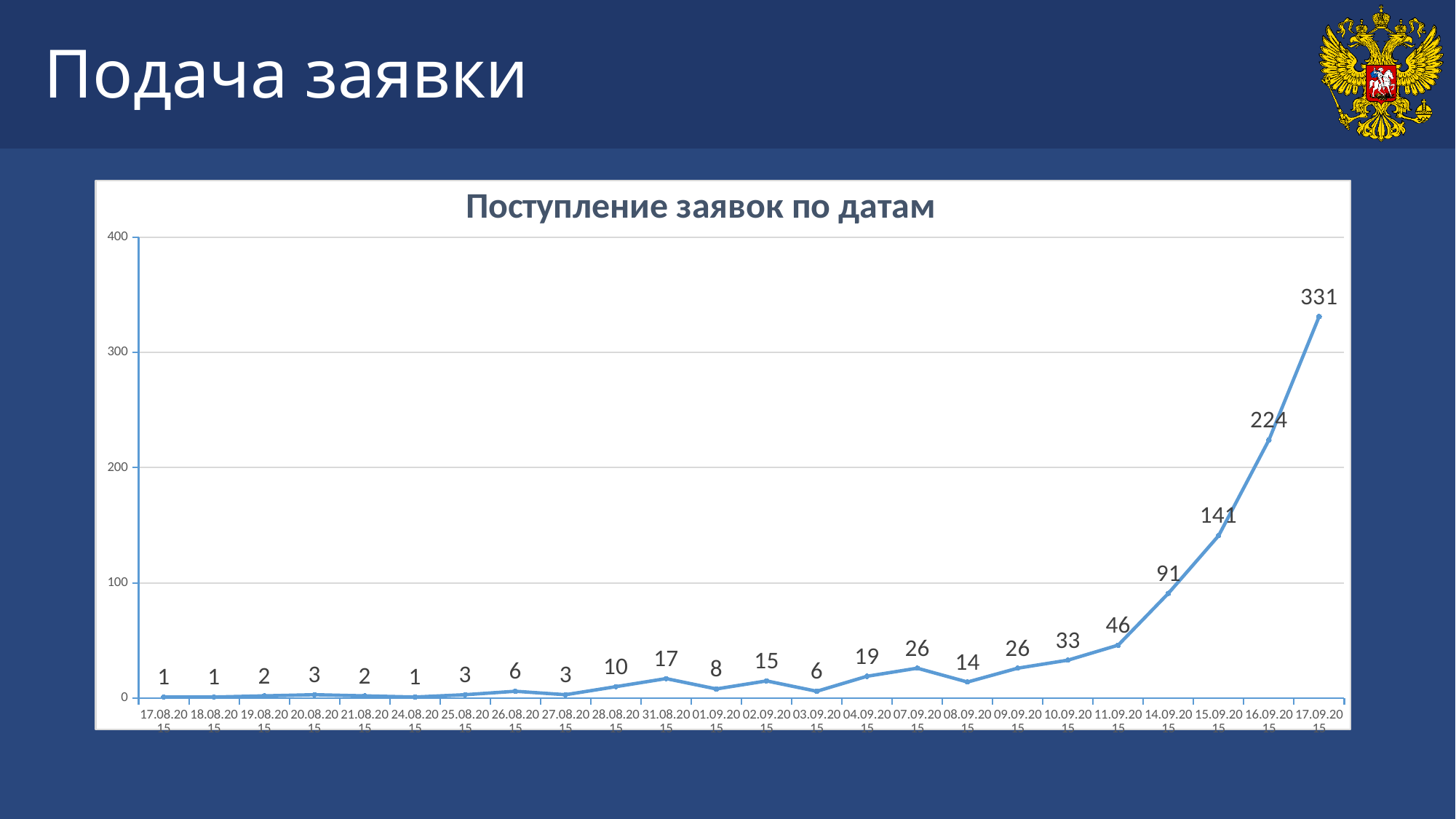
Which is larger, the value for 07.09.2015 or the value for 08.09.2015? 07.09.2015 Do the values generally rise or fall from 11.09.2015 to 17.09.2015? rise What is the value for 31.08.2015? 17 What is the difference between the values for 15.09.2015 and 14.09.2015? 50 Which date has the highest value? 17.09.2015 What is the value for 14.09.2015? 91 What is the value for 17.09.2015? 331 What kind of chart is shown on the slide? line chart What is the title of the chart? Поступление заявок по датам What is the difference between the values for 17.09.2015 and 16.09.2015? 107 How many data points are plotted on the chart? 24 Is the value for 16.09.2015 greater or less than 200? greater